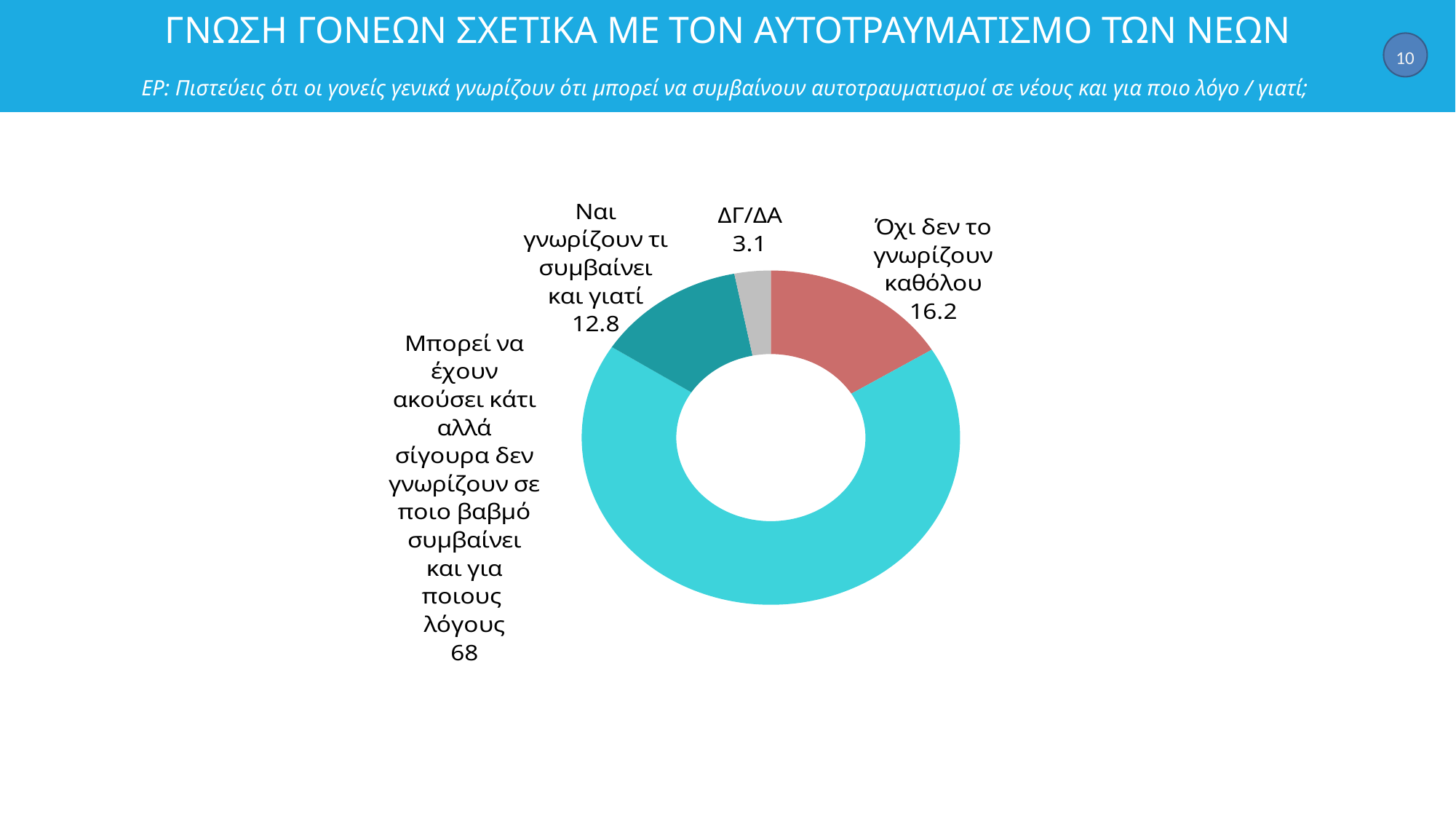
What is the difference between the largest slice (68) and the 'Όχι δεν το γνωρίζουν καθόλου' slice? 51.8 What value is shown for the slice 'Μπορεί να έχουν ακούσει κάτι αλλά σίγουρα δεν γνωρίζουν σε ποιο βαβμό συμβαίνει και για ποιους λόγους'? 68 What is the difference between the values for 'Όχι δεν το γνωρίζουν καθόλου' and 'Ναι γνωρίζουν τι συμβαίνει και γιατί'? 3.4 Which slice has the smallest value? ΔΓ/ΔΑ Which is larger: 'Όχι δεν το γνωρίζουν καθόλου' or 'Ναι γνωρίζουν τι συμβαίνει και γιατί'? Όχι δεν το γνωρίζουν καθόλου Which slice has the largest value? Μπορεί να έχουν ακούσει κάτι αλλά σίγουρα δεν γνωρίζουν σε ποιο βαβμό συμβαίνει και για ποιους λόγους What colour is the 'ΔΓ/ΔΑ' slice? Grey What value is shown for the slice 'Ναι γνωρίζουν τι συμβαίνει και γιατί'? 12.8 What kind of chart is shown on the slide? Doughnut chart What value is shown for the slice 'Όχι δεν το γνωρίζουν καθόλου'? 16.2 What value is shown for the 'ΔΓ/ΔΑ' slice? 3.1 How many slices does the chart have? 4